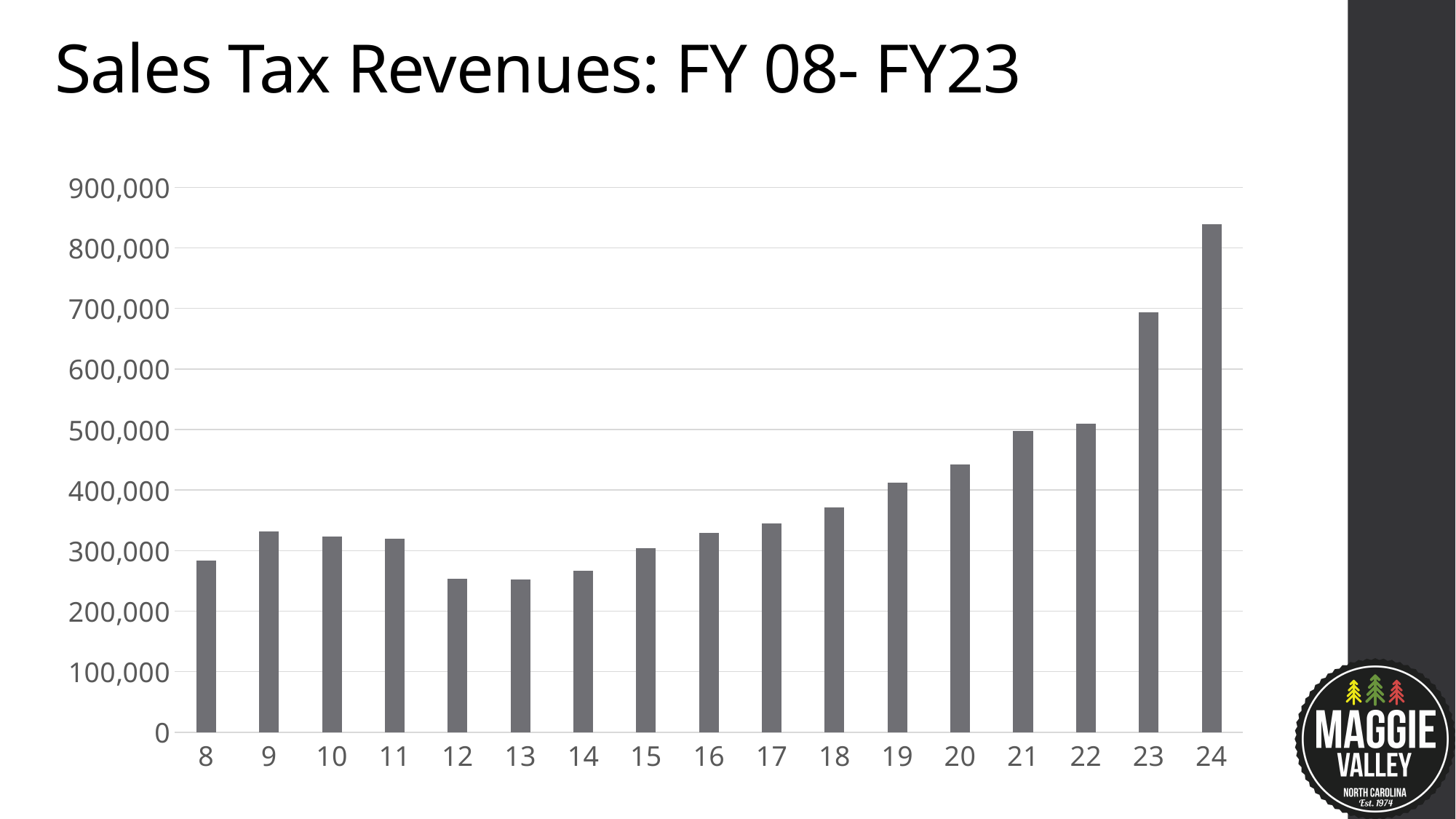
Do the values rise or fall from fiscal year 15 to fiscal year 24? rise Is the value for fiscal year 8 greater or less than 300,000? less Is the value for fiscal year 24 greater or less than 800,000? greater Is the value for fiscal year 19 greater or less than 400,000? greater What kind of chart is shown on the slide? bar chart How many bars (fiscal years) are plotted on the chart? 17 Which is larger, the value for fiscal year 13 or fiscal year 18? 18 What is the title of the chart? Sales Tax Revenues: FY 08- FY23 Which is larger, the value for fiscal year 23 or fiscal year 24? 24 Which fiscal year has the highest sales tax revenue? 24